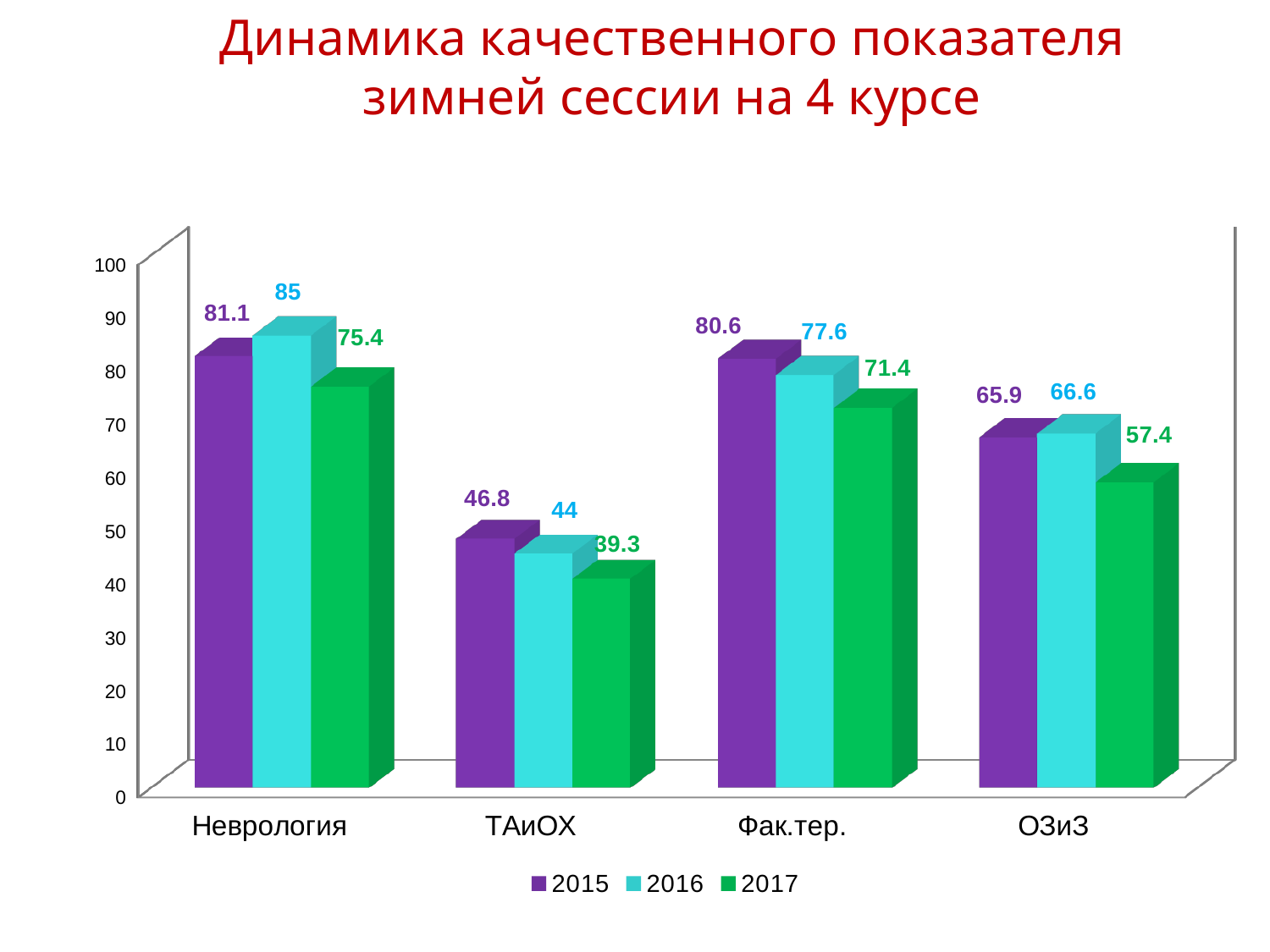
What is the value for ОЗиЗ in 2015? 65.9 What is the value for Неврология in 2016? 85 Is the 2017 value for Неврология greater or less than 70? greater What is the difference between the 2015 and 2017 values for Фак.тер.? 9.2 What kind of chart is shown on the slide? bar chart How many series does the legend list? 3 Do the values for Фак.тер. rise or fall from 2015 to 2017? fall Which category has the highest value in 2016? Неврология How many categories are shown on the x axis? 4 Which is larger for ОЗиЗ: the 2016 value or the 2017 value? 2016 Which category has the lowest value in 2015? ТАиОХ What is the value for ТАиОХ in 2017? 39.3